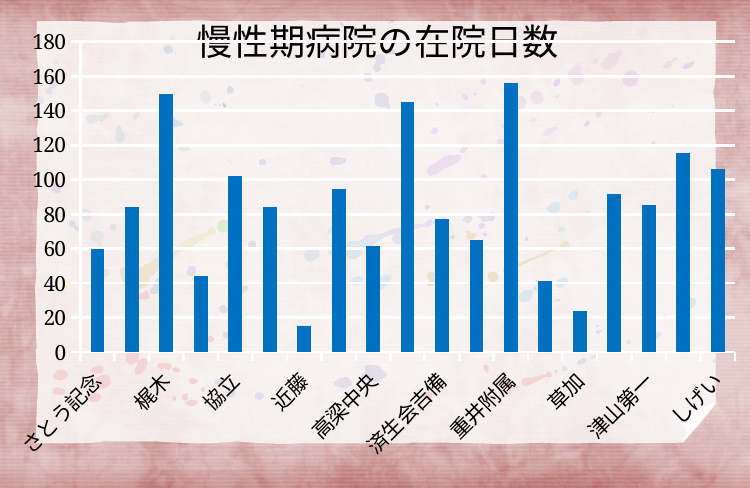
Which has a larger value, 梶木 or 草加? 梶木 Which labeled hospital has the lowest value in the chart? 近藤 Is the value for 近藤 greater or less than 20? less What kind of chart is shown on the slide? bar chart Which has a larger value, 近藤 or 重井附属? 重井附属 Is the value for さとう記念 greater or less than 80? less Is the value for 草加 greater or less than 40? less What is the title of the chart? 慢性期病院の在院日数 How many hospital names are labeled on the x axis? 10 What is the highest value shown on the y axis? 180